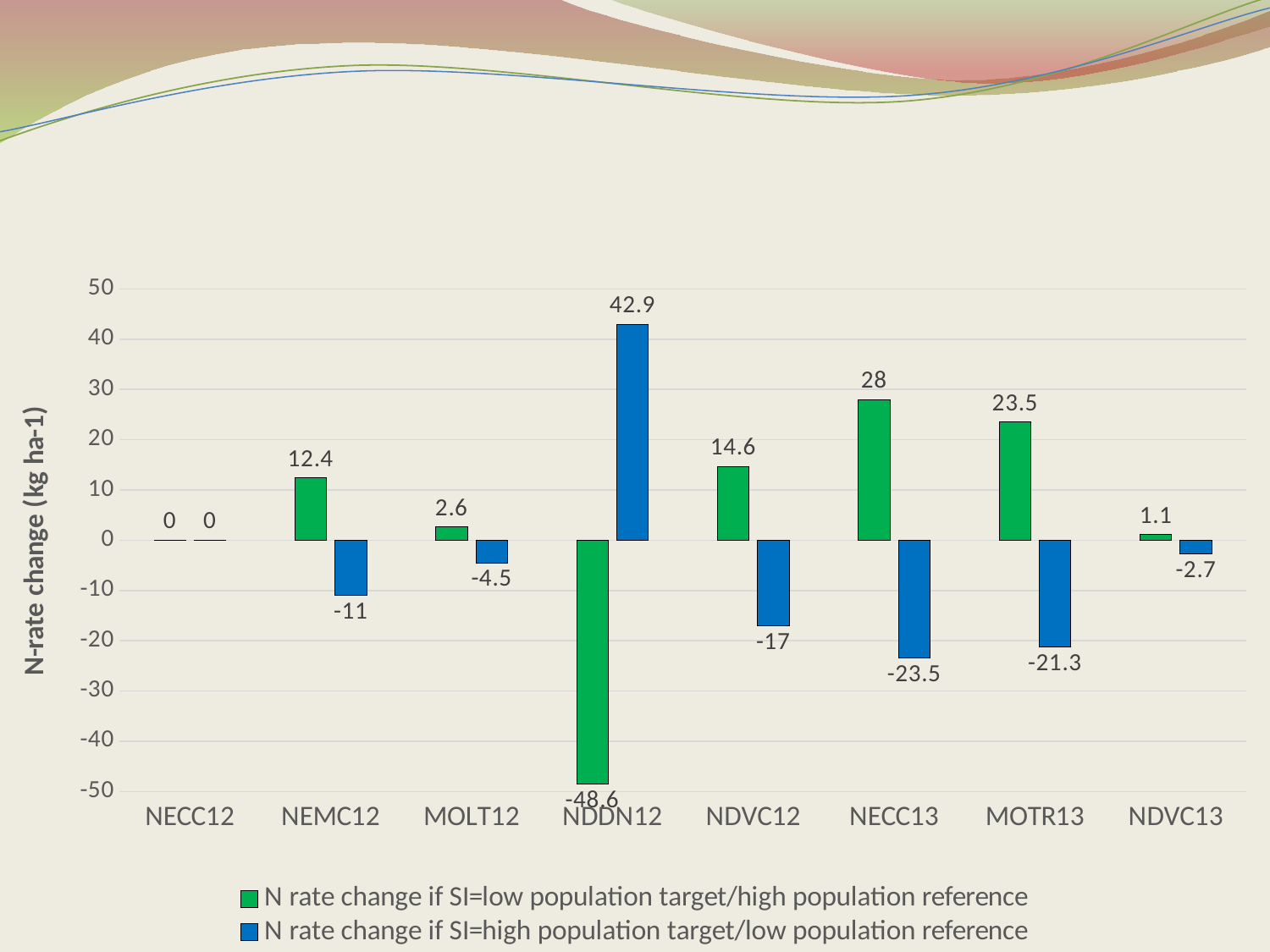
How many series does the legend list? 2 What is the value for MOTR13 in the 'N rate change if SI=high population target/low population reference' series? -21.3 What is the difference between the 'N rate change if SI=low population target/high population reference' values for NECC13 and MOTR13? 4.5 What type of chart is shown on the slide? bar chart What is the value for NDDN12 in the 'N rate change if SI=high population target/low population reference' series? 42.9 Which is larger in the 'N rate change if SI=low population target/high population reference' series: NEMC12 or NDVC12? NDVC12 Which category has the lowest value in the 'N rate change if SI=low population target/high population reference' series? NDDN12 What is the value for NECC13 in the 'N rate change if SI=low population target/high population reference' series? 28 What is the y-axis title of the chart? N-rate change (kg ha-1) Which category has the highest value in the 'N rate change if SI=high population target/low population reference' series? NDDN12 What colour represents the 'N rate change if SI=high population target/low population reference' series? blue How many categories are shown on the x axis? 8